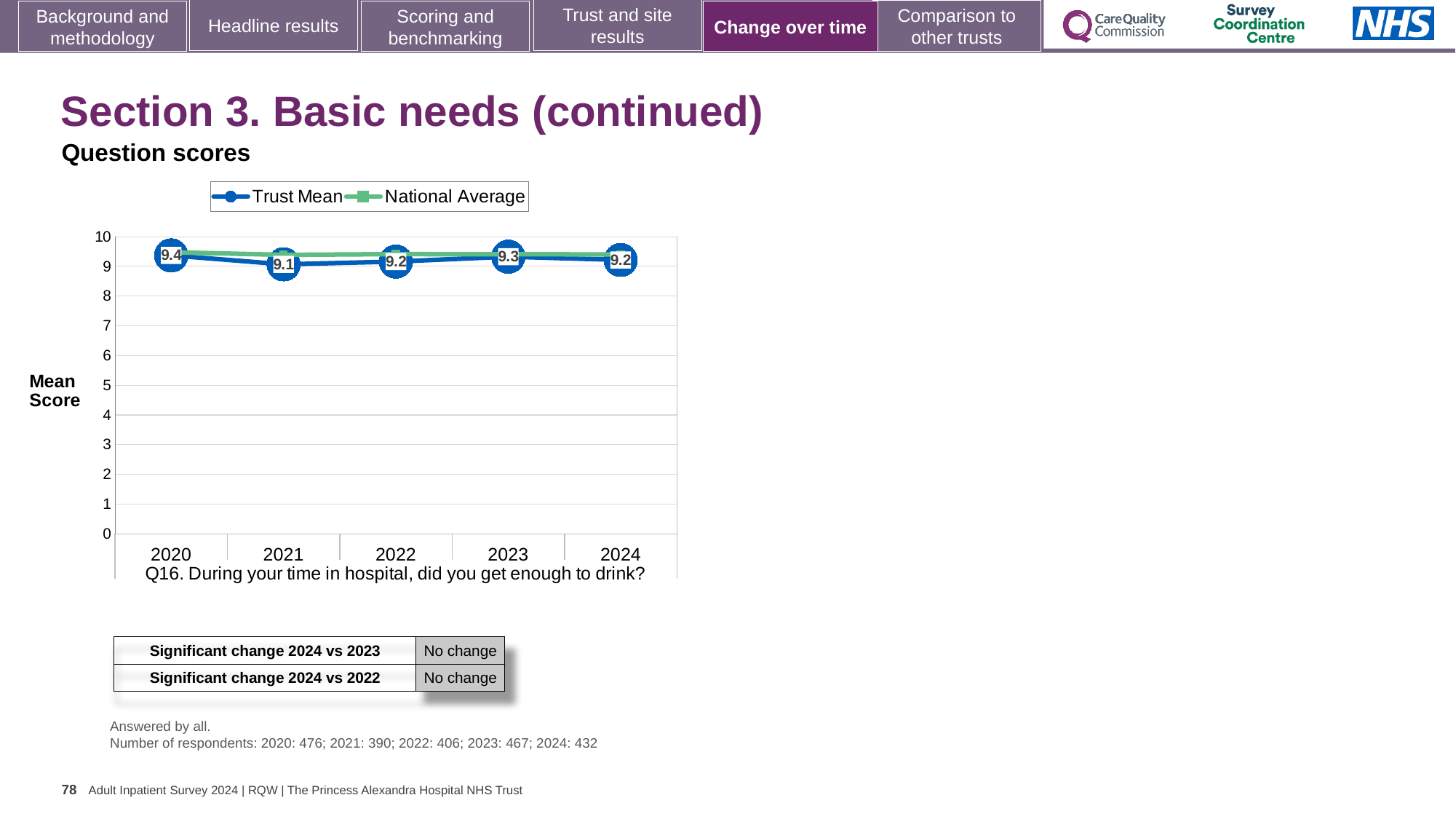
In which year is the Trust Mean score lowest? 2021 What is the Trust Mean score for 2020? 9.4 What is the difference between the Trust Mean scores for 2020 and 2021? 0.3 What is the Trust Mean score for 2024? 9.2 Is the National Average value for 2020 greater or less than 9? greater What is the Trust Mean score for 2021? 9.1 Does the Trust Mean score rise or fall from 2020 to 2021? Fall Which year has the larger Trust Mean score, 2021 or 2023? 2023 In which year is the Trust Mean score highest? 2020 How many series does the chart legend list? 2 What kind of chart is shown on the slide? Line chart How many years are shown on the x axis of the chart? 5